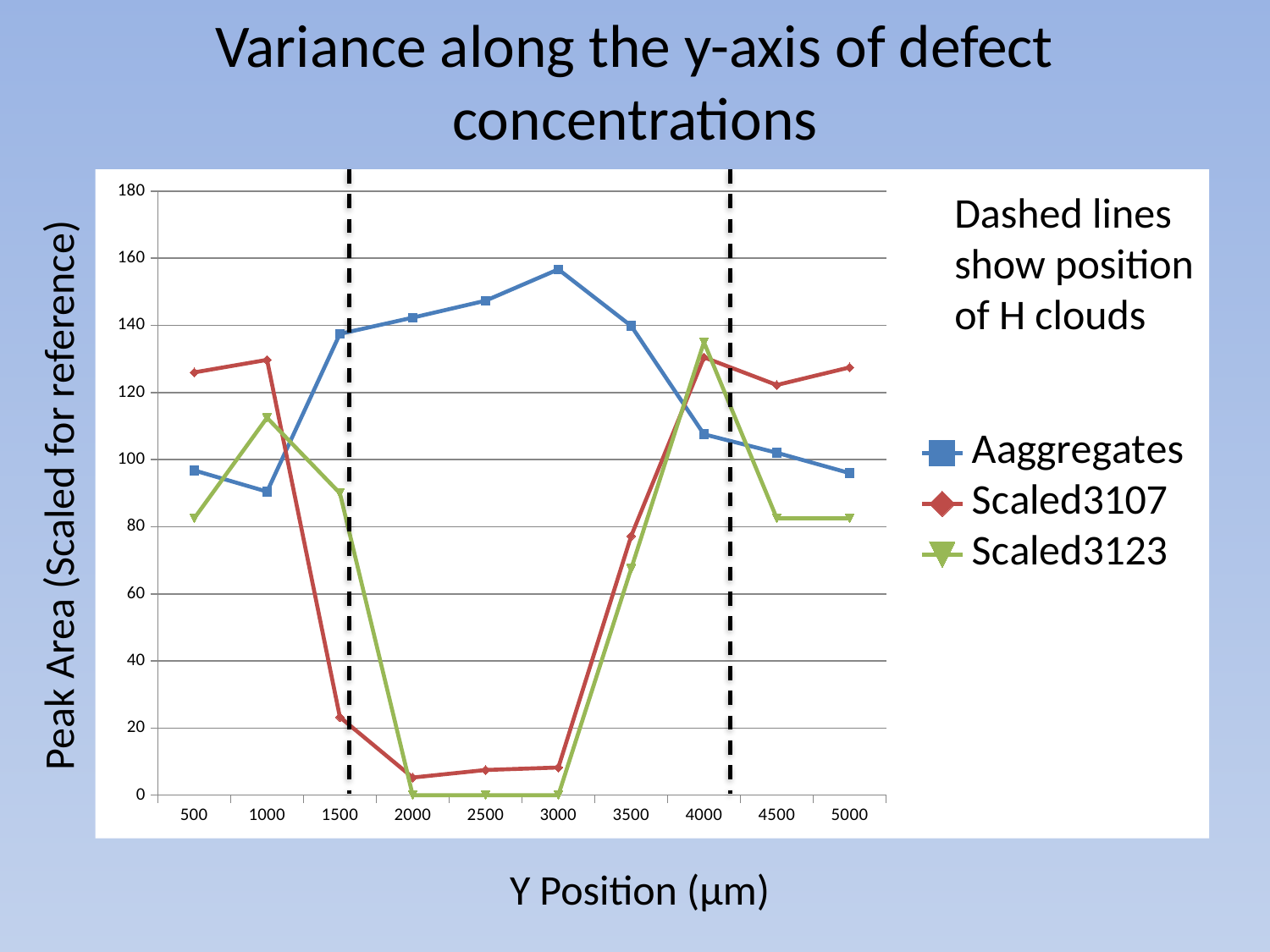
At which Y Position does the Aaggregates series reach its highest value? 3000 How many series does the legend list? 3 What kind of chart is shown on the slide? line chart How many Y Position points are plotted along the x axis? 10 At Y Position 1000, which series has the larger value, Scaled3107 or Scaled3123? Scaled3107 Is the value for Scaled3107 at Y Position 2000 greater or less than 20? less At which Y Position does the Scaled3123 series reach its highest value? 4000 Is the value for Scaled3123 at Y Position 500 greater or less than 100? less Does the Aaggregates series rise or fall from Y Position 3000 to 5000? fall Is the value for Aaggregates at Y Position 3000 greater or less than 140? greater At Y Position 2500, which series has the larger value, Aaggregates or Scaled3107? Aaggregates What is the x-axis title of the chart? Y Position (µm)